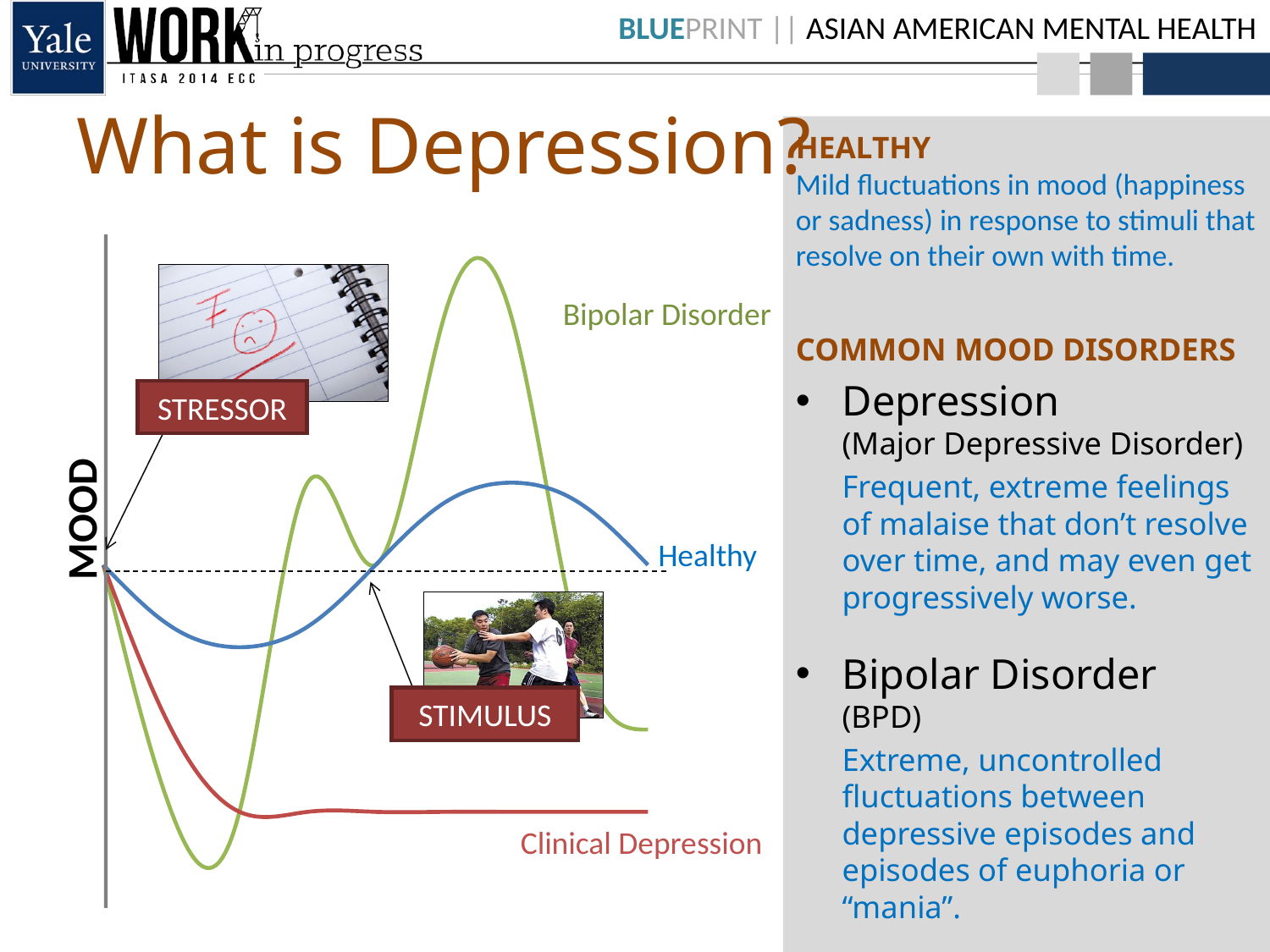
What colour is the Healthy curve on the chart? blue Does the Clinical Depression curve return to the dashed baseline by the right side of the chart? No Which curve ends lower at the right side of the chart, Healthy or Clinical Depression? Clinical Depression After the stressor, does the Healthy curve first fall or rise? fall Which curve reaches the lowest point on the mood chart? Bipolar Disorder What is the label on the vertical axis of the chart? MOOD Which curve reaches the highest peak on the mood chart? Bipolar Disorder Which curve has the larger swings in mood, Healthy or Bipolar Disorder? Bipolar Disorder What kind of chart is shown on the slide? line chart Does the Clinical Depression curve rise or fall immediately after the stressor? fall How many curves (series) are plotted on the mood chart? 3